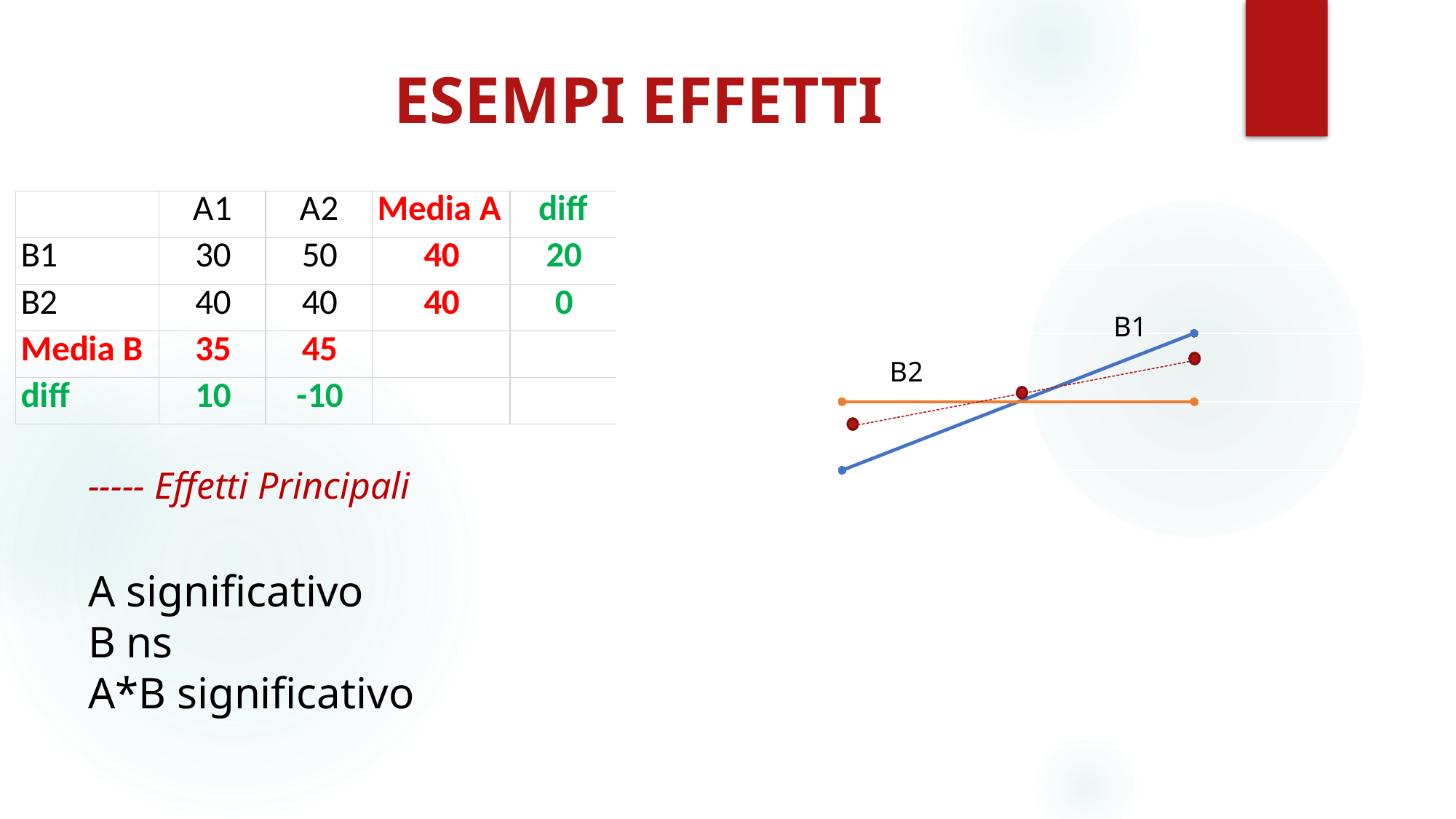
How many labelled solid lines does the chart on the right show? 2 At the left end of the chart, which line is higher, B1 or B2? B2 According to the slide, what does the dashed line in the chart represent? Effetti Principali Which line is steeper, B1 or B2? B1 At the right end of the chart, which line is higher, B1 or B2? B1 What kind of chart is shown on the right of the slide? line chart What colour is the B1 line in the chart? blue Does the B1 line rise or fall from left to right? rise Does the B2 line rise, fall or stay level from left to right? stay level